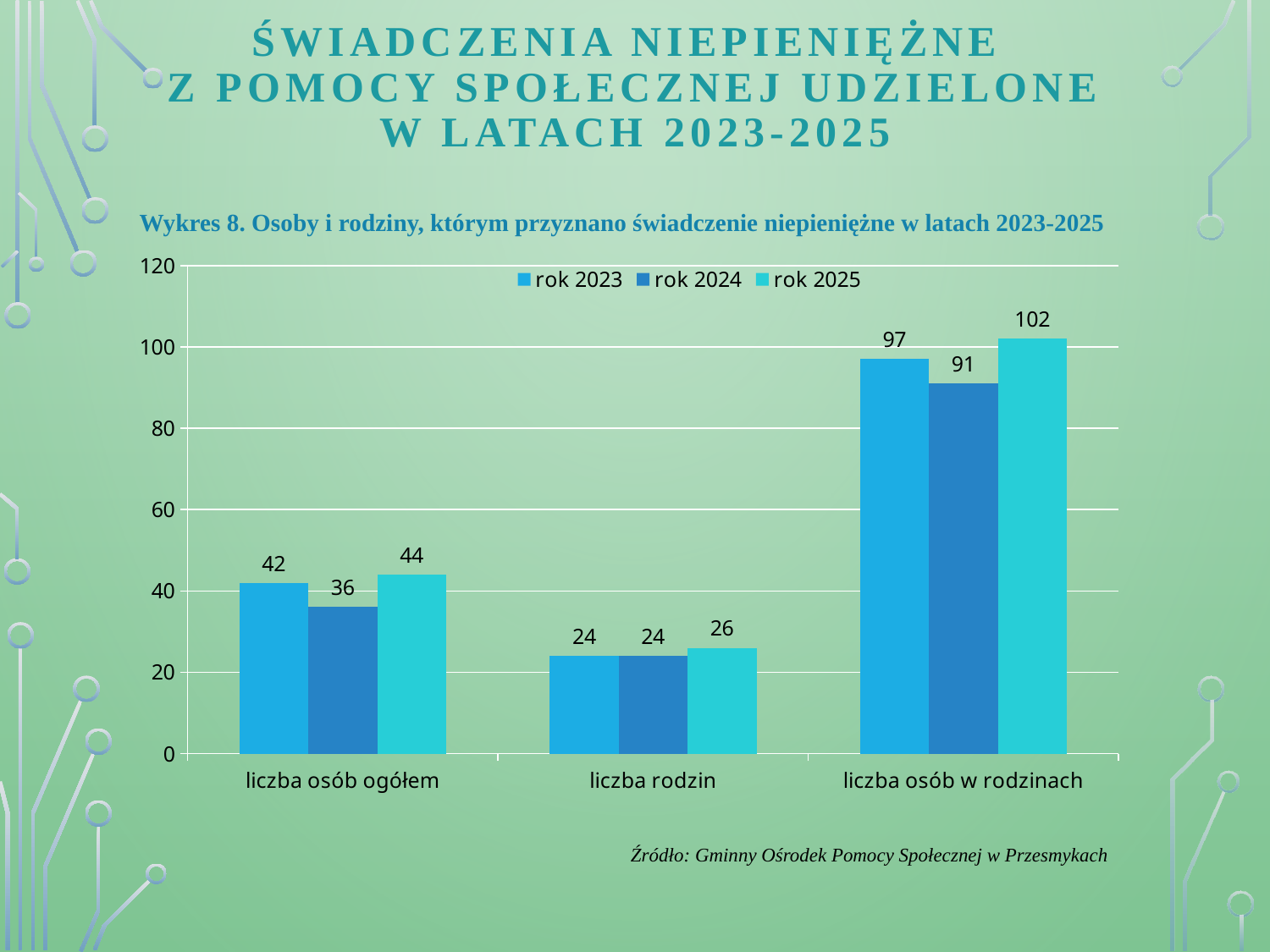
How many series does the legend list? 3 Which is larger for 'liczba osób ogółem': the 'rok 2023' value or the 'rok 2024' value? rok 2023 Which category has the highest value in the 'rok 2025' series? liczba osób w rodzinach What is the difference between the 'rok 2025' and 'rok 2024' values for 'liczba osób w rodzinach'? 11 Which category has the lowest value in the 'rok 2023' series? liczba rodzin How many categories are shown on the x axis? 3 What kind of chart is shown on the slide? bar chart What is the difference between the 'rok 2023' and 'rok 2024' values for 'liczba osób ogółem'? 6 What is the title of the chart? Wykres 8. Osoby i rodziny, którym przyznano świadczenie niepieniężne w latach 2023-2025 What is the value for 'liczba osób ogółem' in the 'rok 2023' series? 42 What is the value for 'liczba rodzin' in the 'rok 2025' series? 26 What is the value for 'liczba osób w rodzinach' in the 'rok 2024' series? 91